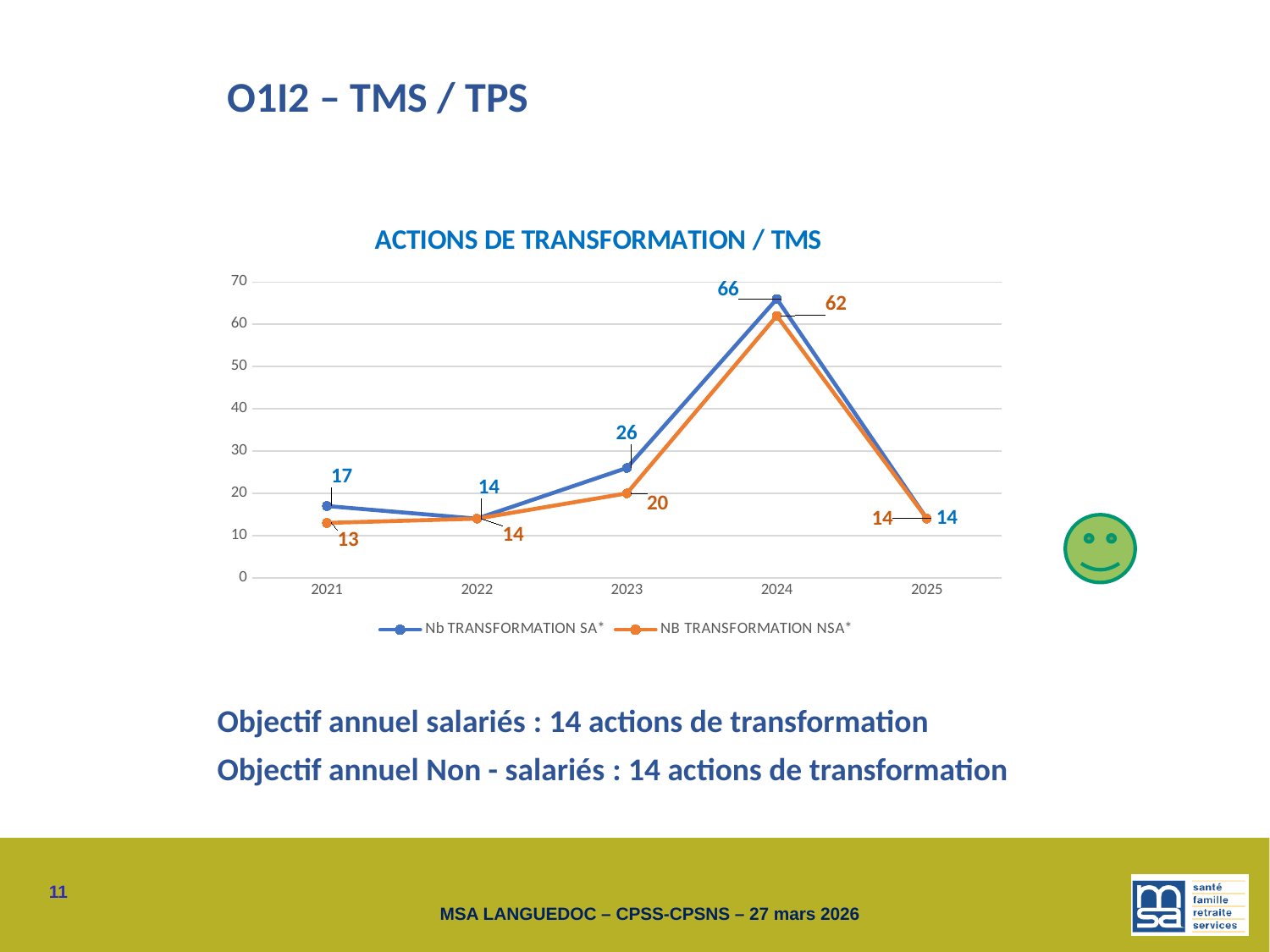
What is the title of the chart? ACTIONS DE TRANSFORMATION / TMS What is the value of NB TRANSFORMATION NSA* in 2023? 20 What type of chart is shown on the slide? line chart How many series does the legend list? 2 Does Nb TRANSFORMATION SA* rise or fall from 2024 to 2025? fall How many years are plotted on the x axis? 5 What is the difference between Nb TRANSFORMATION SA* and NB TRANSFORMATION NSA* in 2024? 4 Which series has the larger value in 2023, Nb TRANSFORMATION SA* or NB TRANSFORMATION NSA*? Nb TRANSFORMATION SA* What is the value of Nb TRANSFORMATION SA* in 2024? 66 What is the value of NB TRANSFORMATION NSA* in 2021? 13 In which year is Nb TRANSFORMATION SA* highest? 2024 In which year is NB TRANSFORMATION NSA* lowest? 2021